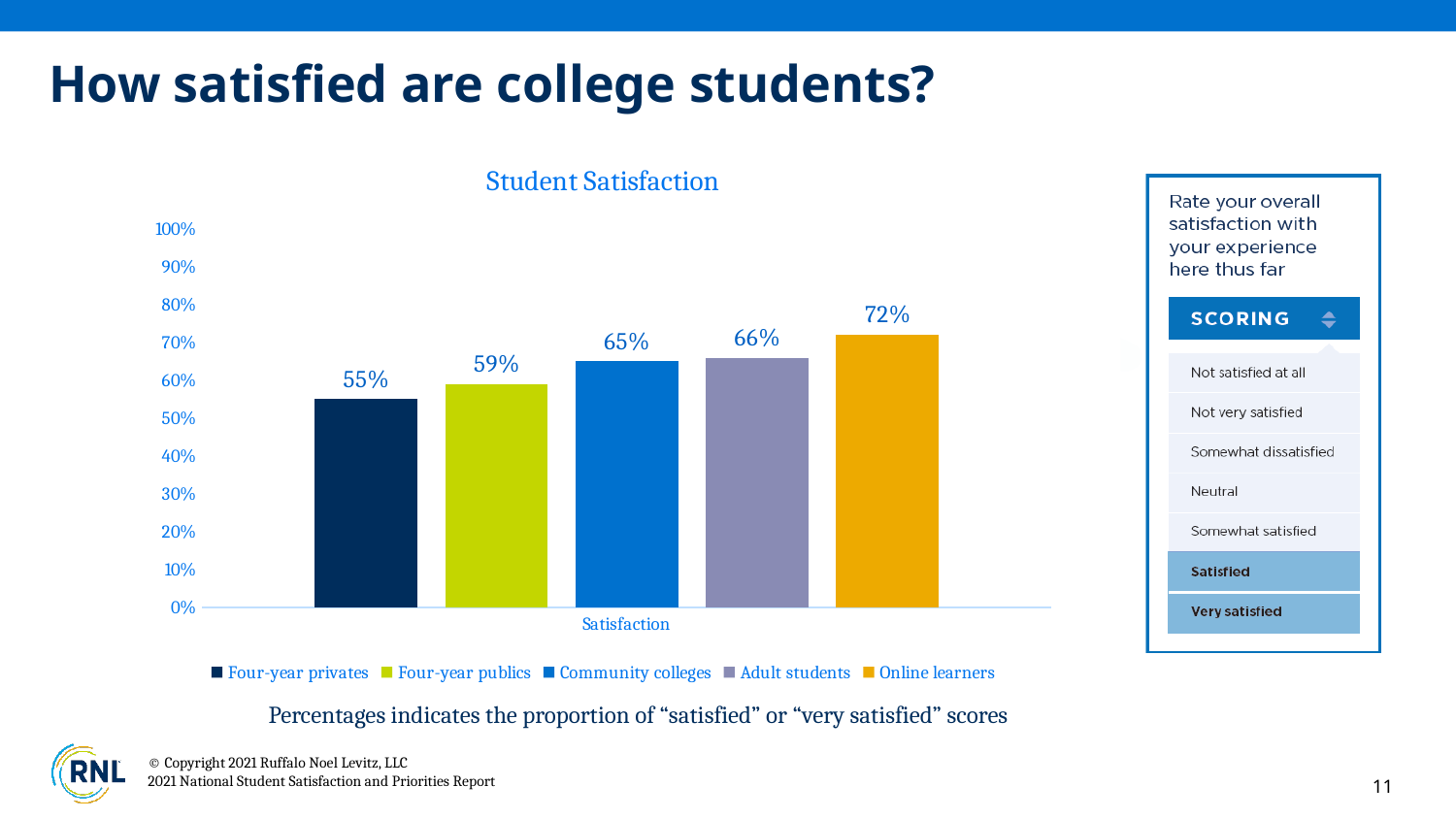
What kind of chart is shown on the slide? Bar chart Which series has the highest satisfaction value? Online learners What is the satisfaction value for Four-year privates? 55% What is the satisfaction value for Online learners? 72% What is the difference between the satisfaction values for Four-year publics and Four-year privates? 4% Which is larger, the satisfaction value for Adult students or for Four-year publics? Adult students What is the title of the chart? Student Satisfaction Is the value for Four-year publics greater or less than 50%? greater What is the satisfaction value for Community colleges? 65% Which series has the lowest satisfaction value? Four-year privates How many series does the legend list? 5 What is the difference between the satisfaction values for Online learners and Four-year privates? 17%